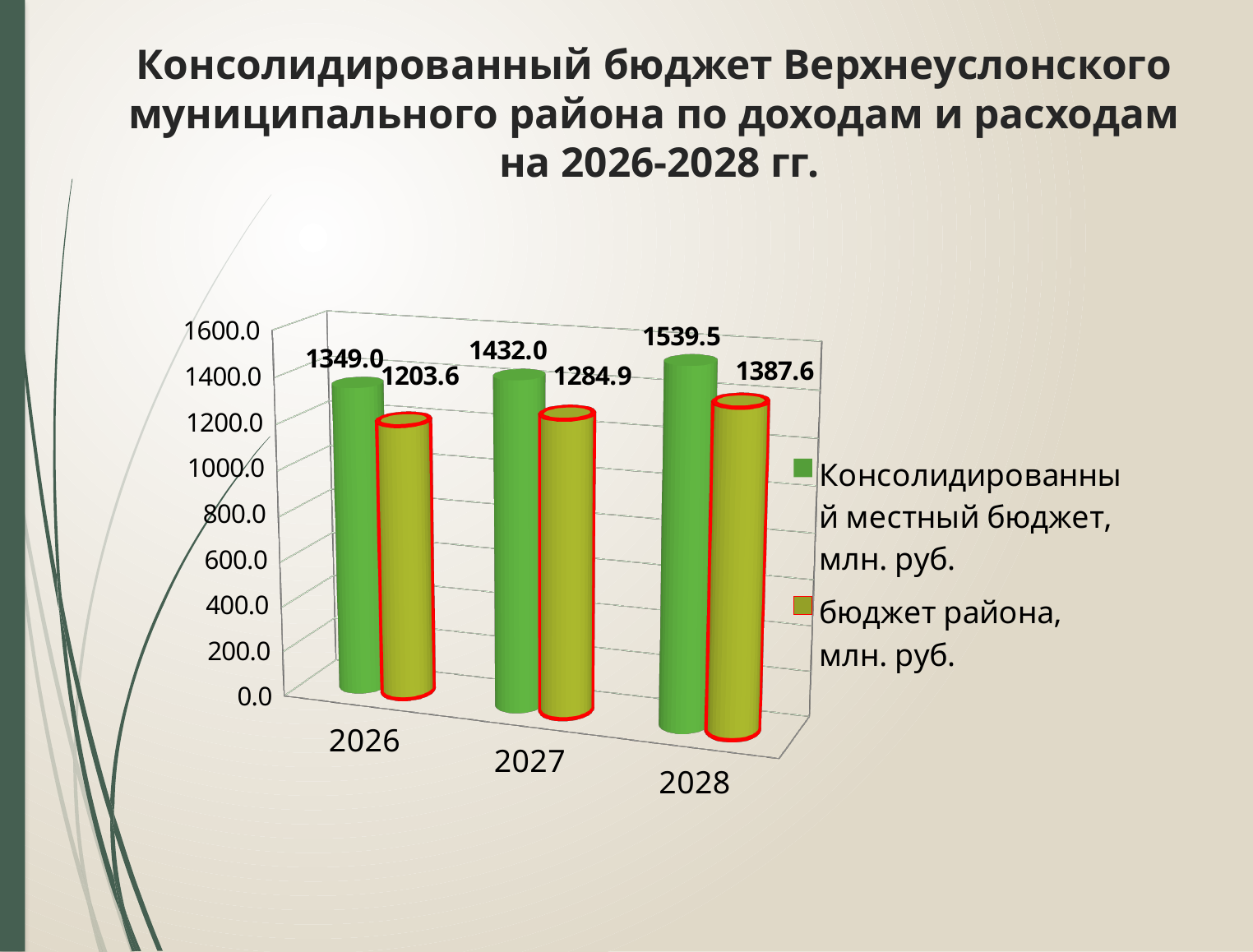
How many years are shown on the x axis? 3 What is the value of the consolidated local budget (Консолидированный местный бюджет) for 2027? 1432.0 In which year is the consolidated local budget the highest? 2028 Which is larger in 2027: the consolidated local budget or the district budget? Консолидированный местный бюджет Do the consolidated local budget values rise or fall from 2026 to 2028? rise By how much does the consolidated local budget grow from 2027 to 2028? 107.5 What is the value of the district budget (бюджет района) for 2026? 1203.6 Is the district budget for 2028 greater or less than 1400.0? less In which year is the district budget the lowest? 2026 How many series does the legend list? 2 What is the value of the district budget (бюджет района) for 2028? 1387.6 What is the difference between the consolidated local budget and the district budget in 2026? 145.4